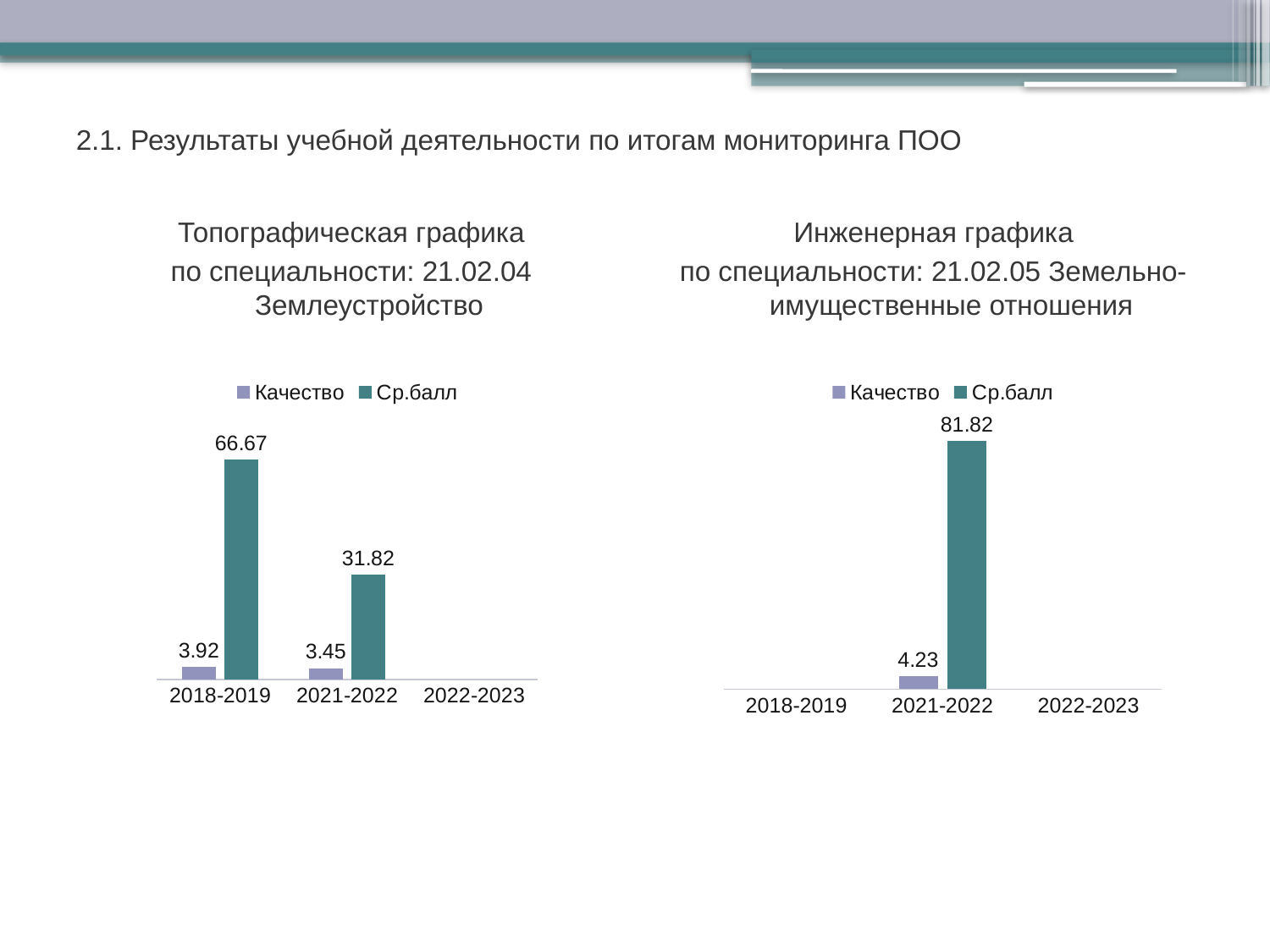
In the right chart (Инженерная графика), what is the Качество value for 2021-2022? 4.23 What kind of chart is the right chart (Инженерная графика)? bar chart In the left chart (Топографическая графика), does the Ср.балл value rise or fall from 2018-2019 to 2021-2022? fall How many categories are shown on the x axis of the right chart (Инженерная графика)? 3 In the left chart (Топографическая графика), what is the Ср.балл value for 2018-2019? 66.67 In the left chart (Топографическая графика), what is the difference between the Качество values for 2018-2019 and 2021-2022? 0.47 In the left chart (Топографическая графика), what is the difference between the Ср.балл values for 2018-2019 and 2021-2022? 34.85 In the left chart (Топографическая графика), which year has the higher Ср.балл value, 2018-2019 or 2021-2022? 2018-2019 In the right chart (Инженерная графика), what is the Ср.балл value for 2021-2022? 81.82 In the left chart (Топографическая графика), what is the Качество value for 2021-2022? 3.45 How many series does the legend of the left chart (Топографическая графика) list? 2 What are the two series named in the legend of the right chart (Инженерная графика)? Качество and Ср.балл